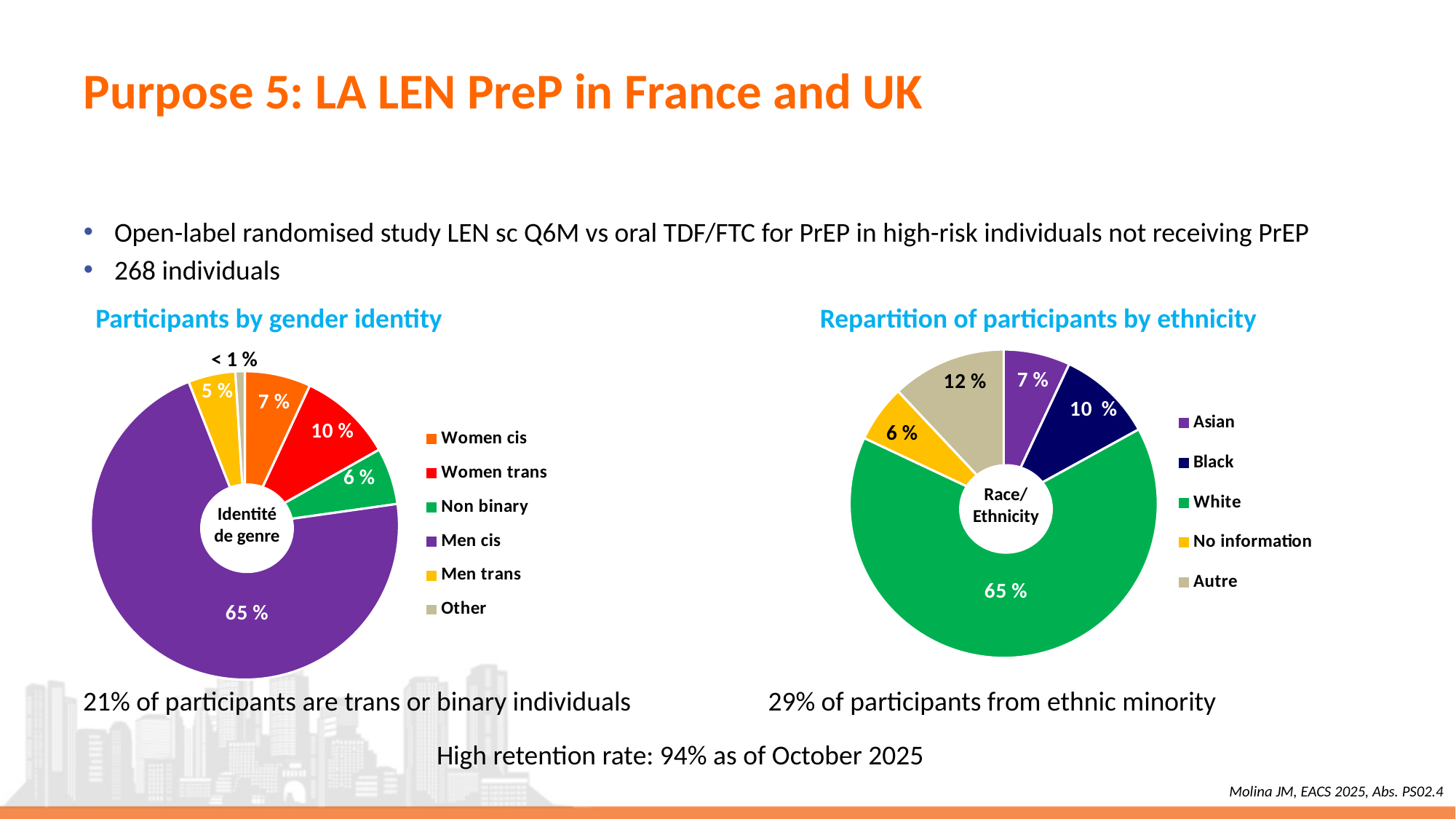
In the 'Participants by gender identity' chart, what percentage of participants are Men cis? 65 % In the 'Repartition of participants by ethnicity' chart, how many categories does the legend list? 5 What kind of chart is used for 'Repartition of participants by ethnicity'? Pie chart (doughnut) In the 'Participants by gender identity' chart, what is the difference between the Women trans and Women cis shares? 3 % In the 'Participants by gender identity' chart, which category has the smallest share? Other In the 'Repartition of participants by ethnicity' chart, what percentage of participants are in the Autre category? 12 % In the 'Repartition of participants by ethnicity' chart, which is larger, the Asian share or the Black share? Black In the 'Repartition of participants by ethnicity' chart, which category has the largest share? White In the 'Participants by gender identity' chart, what percentage of participants are Women trans? 10 % In the 'Participants by gender identity' chart, which category has the largest share? Men cis In the 'Repartition of participants by ethnicity' chart, what percentage of participants are Black? 10 % In the 'Participants by gender identity' chart, how many categories does the legend list? 6